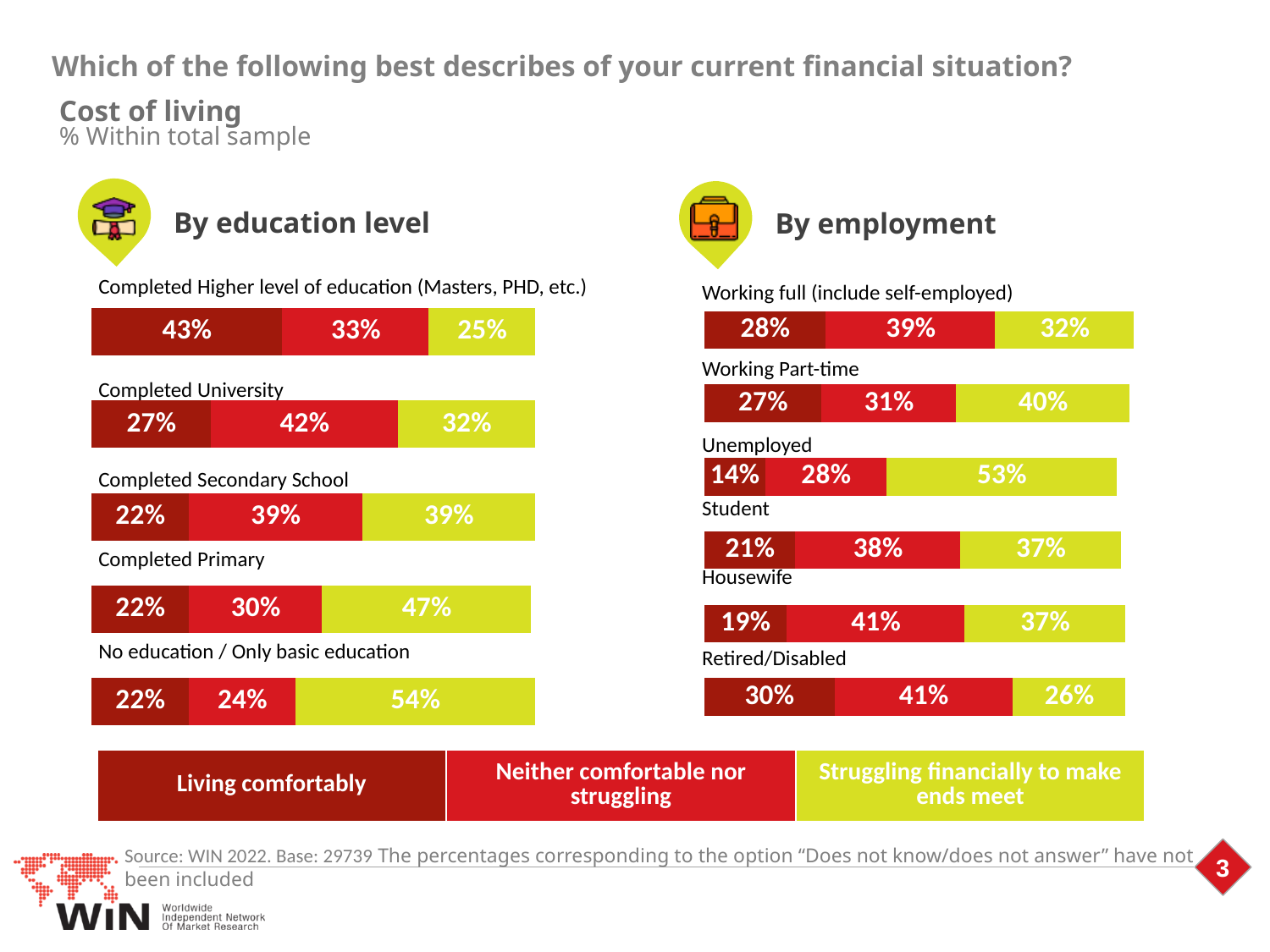
In the 'By employment' chart, which employment group has the lowest share living comfortably? Unemployed How many categories does the legend at the bottom of the slide list? 3 In the 'By education level' chart, what percentage of those who completed higher level of education (Masters, PHD, etc.) are living comfortably? 43% In the 'By employment' chart, what percentage of unemployed respondents are struggling financially to make ends meet? 53% In the 'By employment' chart, which is larger: the struggling financially share for working part-time or for working full (include self-employed)? Working Part-time How many employment categories are shown in the 'By employment' chart? 6 In the 'By education level' chart, what is the difference between the struggling financially share for no education / only basic education and for completed university? 22% In the 'By employment' chart, what is the total of the three segments for the Student bar? 96% In the 'By education level' chart, which education level has the highest share living comfortably? Completed Higher level of education (Masters, PHD, etc.) In the 'By education level' chart, what percentage of those with no education / only basic education are neither comfortable nor struggling? 24% In the 'By employment' chart, what percentage of retired/disabled respondents are living comfortably? 30% What type of chart is used in the 'By education level' section? Stacked bar chart